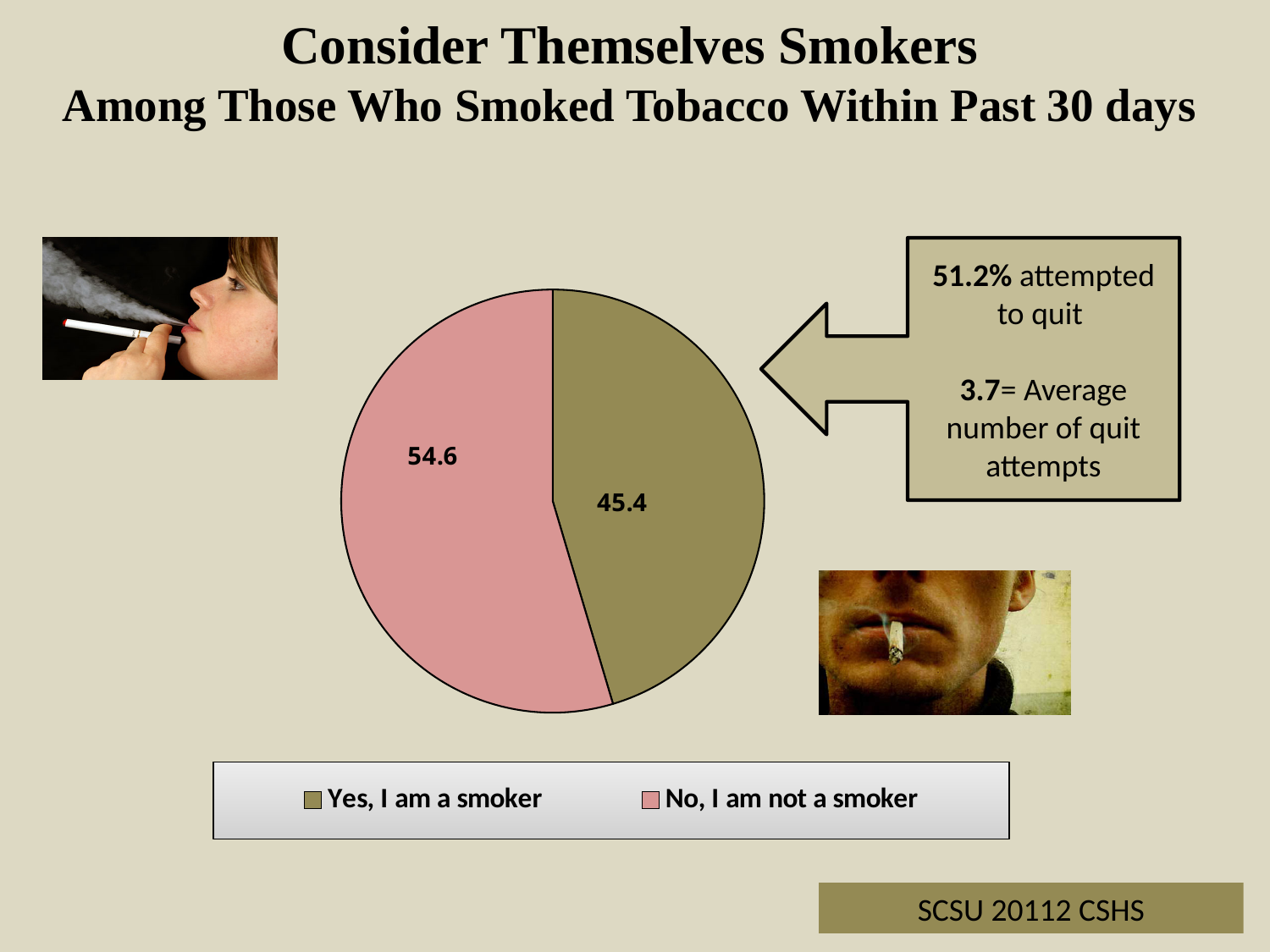
What is the value for "No, I am not a smoker"? 54.6 Which slice is the largest? No, I am not a smoker How many entries does the legend list? 2 What is the total of the two slice values shown? 100 How many slices does the pie chart have? 2 Which slice is the smallest? Yes, I am a smoker Which is larger: "Yes, I am a smoker" or "No, I am not a smoker"? No, I am not a smoker What colour is the "No, I am not a smoker" slice? pink What is the value for "Yes, I am a smoker"? 45.4 What colour is the "Yes, I am a smoker" slice? olive/khaki What kind of chart is shown on the slide? pie chart What is the difference between the "No, I am not a smoker" and "Yes, I am a smoker" values? 9.2